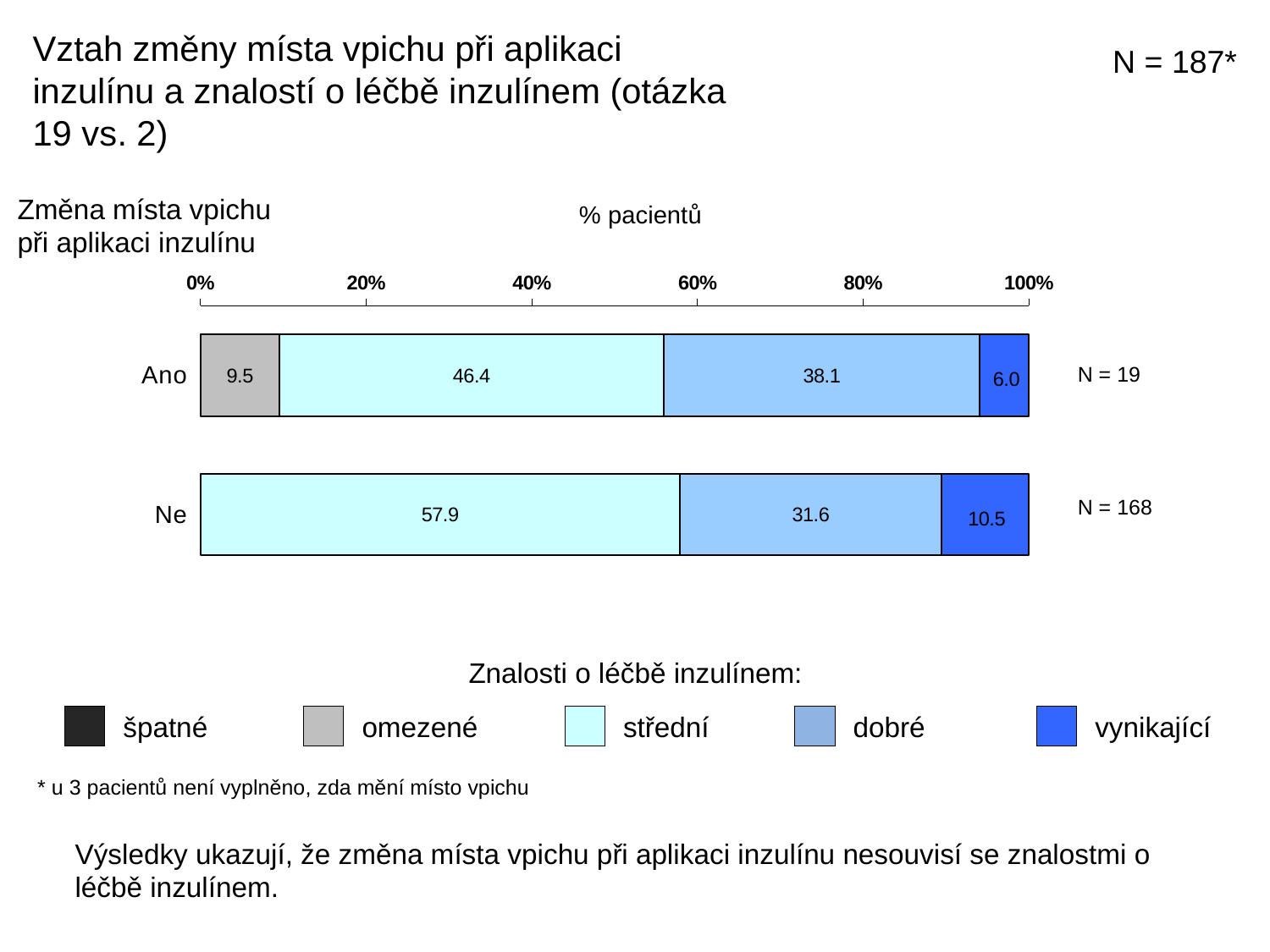
What is the value of the 'omezené' segment for 'Ano'? 9.5 What kind of chart is shown on the slide? stacked bar chart Which segment is the largest in the 'Ne' bar? střední Which is larger: the 'dobré' value for 'Ano' or for 'Ne'? Ano What is the difference between the 'střední' values for 'Ne' and 'Ano'? 11.5 What is the N shown next to the 'Ne' bar? N = 168 What is the value of the 'střední' segment for 'Ano'? 46.4 What is the value of the 'vynikající' segment for 'Ne'? 10.5 What is the value of the 'dobré' segment for 'Ne'? 31.6 How many series does the legend list? 5 Which segment is the smallest in the 'Ano' bar? vynikající How many categories (bars) does the chart show? 2